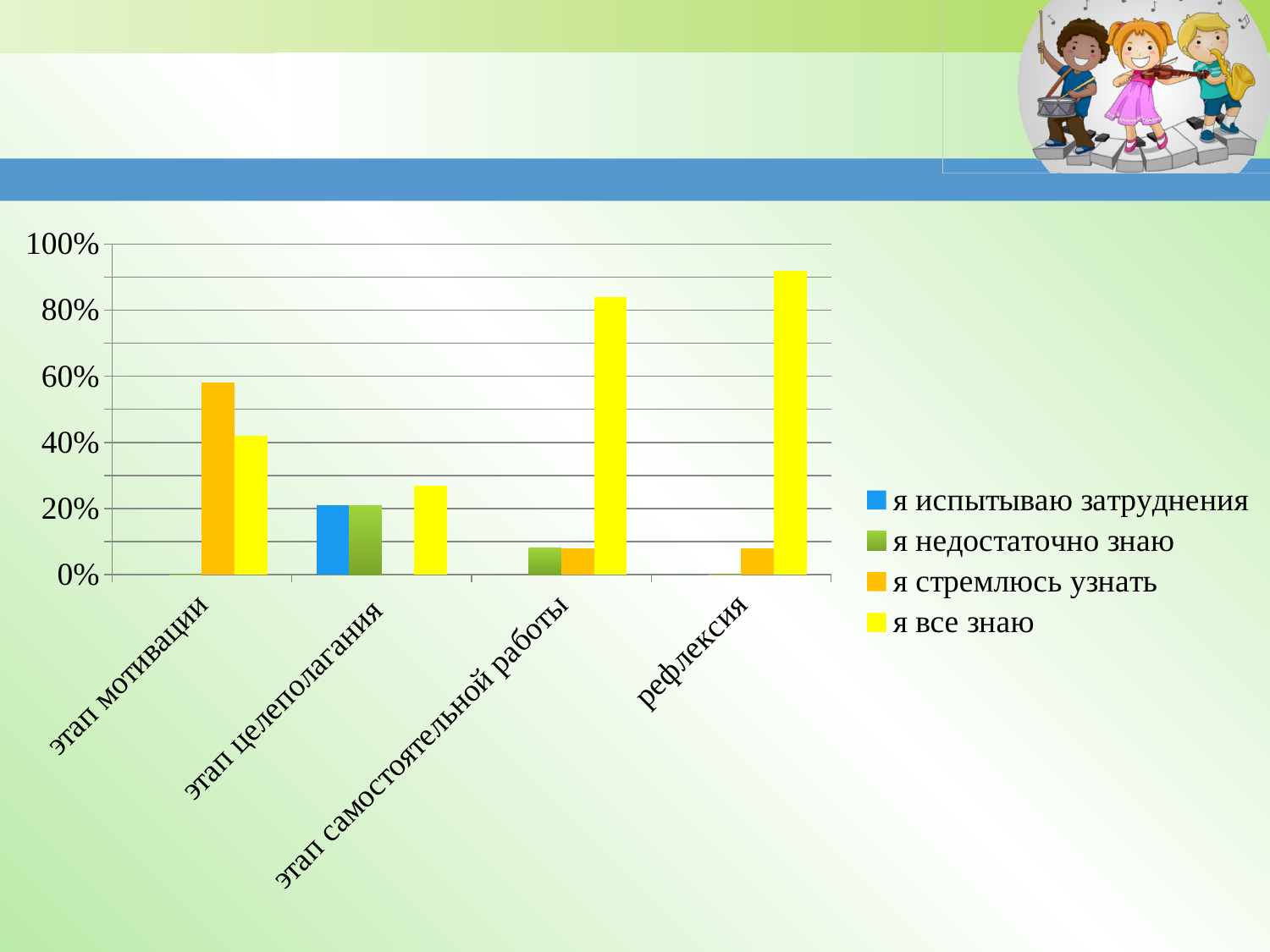
Which category has the shortest bar for the series "я все знаю"? этап целеполагания Which colour represents the series "я недостаточно знаю" in the legend? green Which category has the tallest bar for the series "я все знаю"? рефлексия For этап мотивации, which is larger: "я стремлюсь узнать" or "я все знаю"? я стремлюсь узнать Is the value of "я все знаю" for рефлексия greater or less than 80%? greater Is the value of "я все знаю" for этап самостоятельной работы greater or less than 60%? greater Is the value of "я испытываю затруднения" for этап целеполагания greater or less than 40%? less What kind of chart is shown on the slide? bar chart Does the value of "я все знаю" rise or fall from этап целеполагания to рефлексия? rise How many categories are shown on the x axis? 4 How many series does the legend list? 4